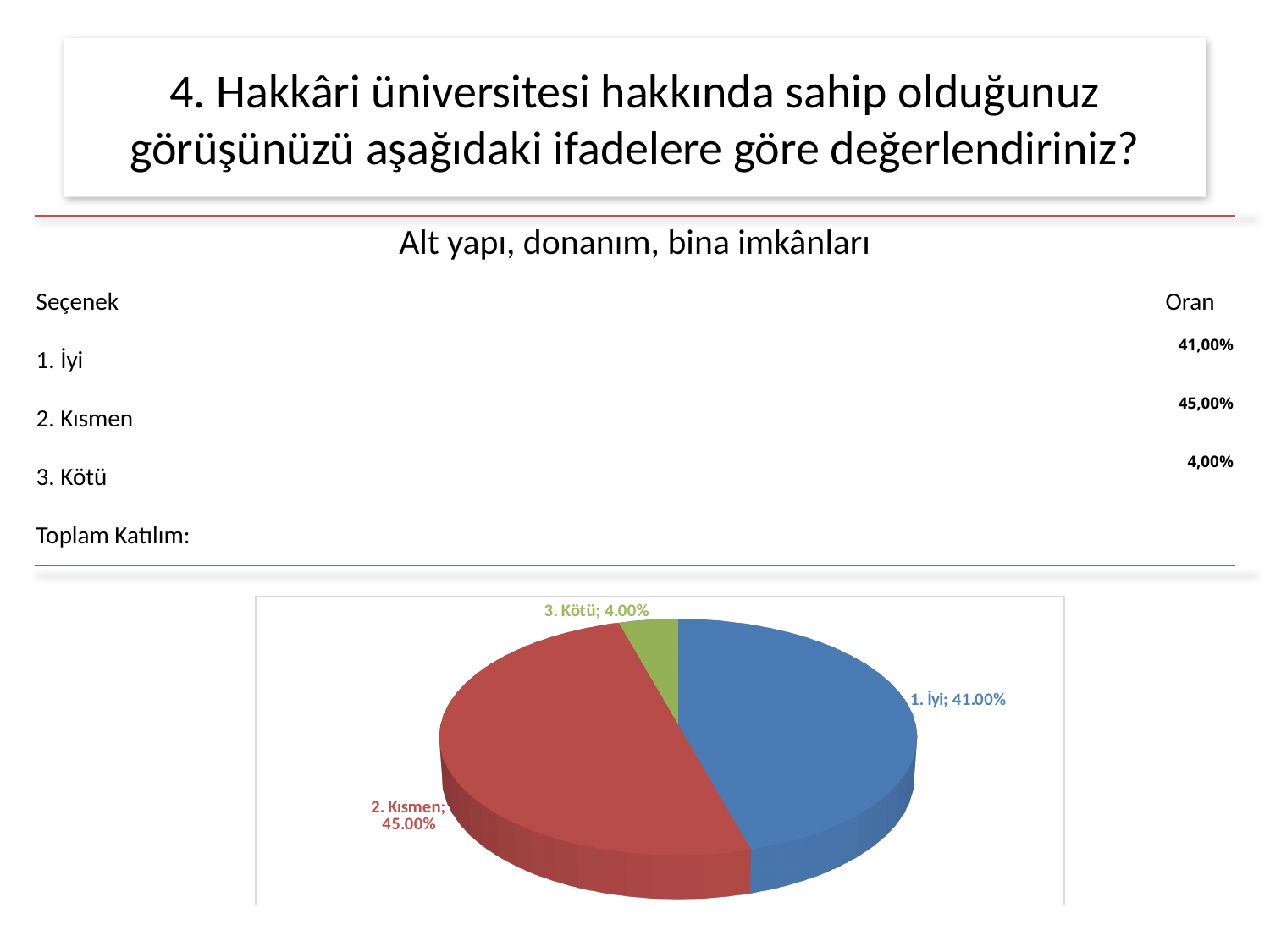
Which category has the largest slice in the pie chart? 2. Kısmen What is the difference between the values for 2. Kısmen and 1. İyi? 4.00% What is the difference between the values for 1. İyi and 3. Kötü? 37.00% What colour is the slice for 2. Kısmen? red Which is larger, the slice for 1. İyi or the slice for 3. Kötü? 1. İyi What is the value for 3. Kötü in the pie chart? 4.00% What kind of chart is shown on the slide? pie chart What is the value for 1. İyi in the pie chart? 41.00% What colour is the slice for 3. Kötü? green What is the value for 2. Kısmen in the pie chart? 45.00% How many slices does the pie chart have? 3 Which category has the smallest slice in the pie chart? 3. Kötü